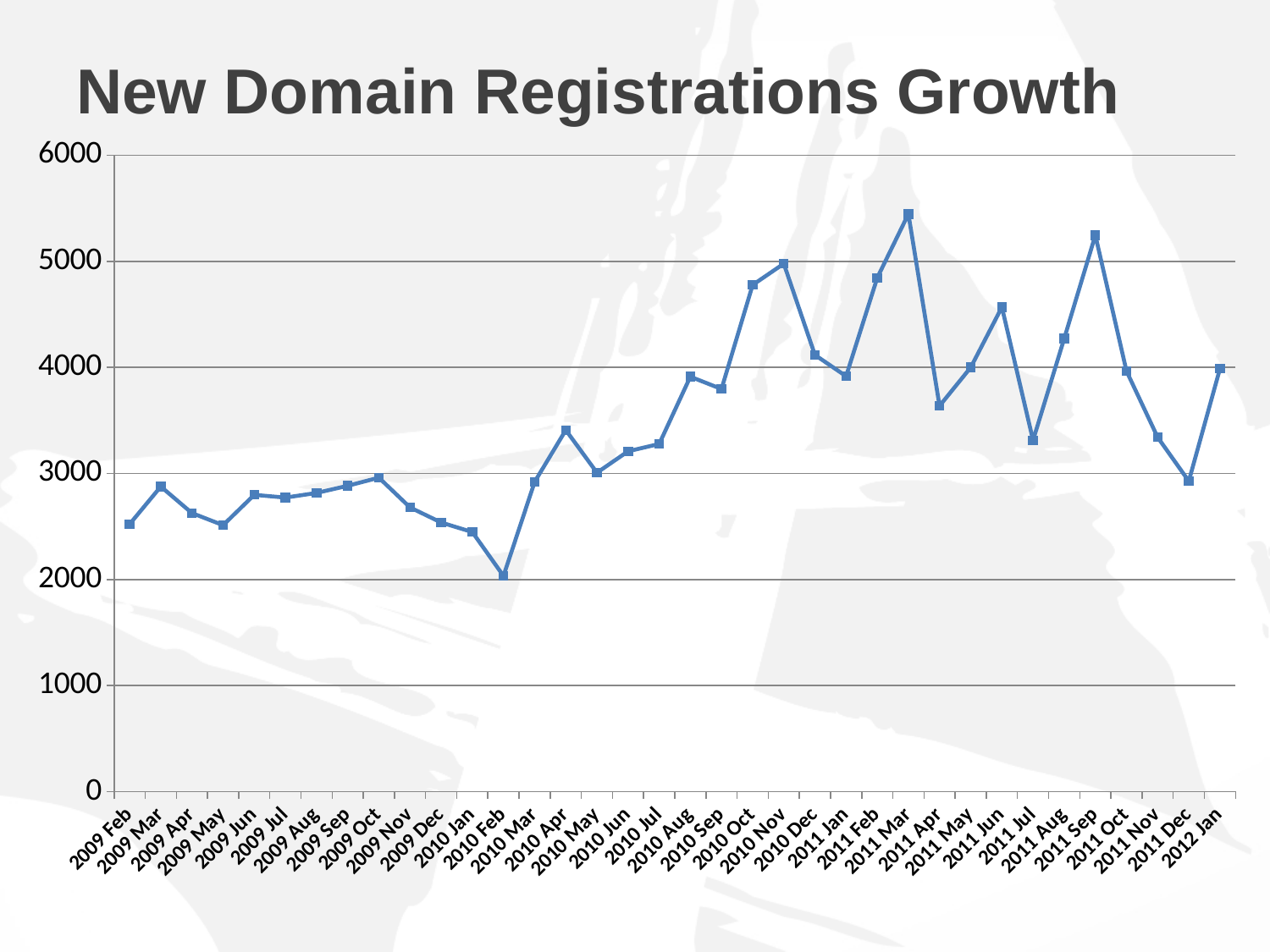
Which month has the lowest value on the chart? 2010 Feb What is the title of the chart? New Domain Registrations Growth Is the value for 2011 Jul greater or less than 4000? less Is the value for 2009 Feb greater or less than 3000? less Overall, do the values rise or fall from 2009 Feb to 2012 Jan? rise Which is larger, the value for 2009 Oct or the value for 2009 Feb? 2009 Oct Which month has the highest value on the chart? 2011 Mar How many monthly data points are plotted on the chart? 36 Which is larger, the value for 2011 Mar or the value for 2011 Sep? 2011 Mar What kind of chart is shown on the slide? line chart Is the value for 2010 Oct greater or less than 4000? greater